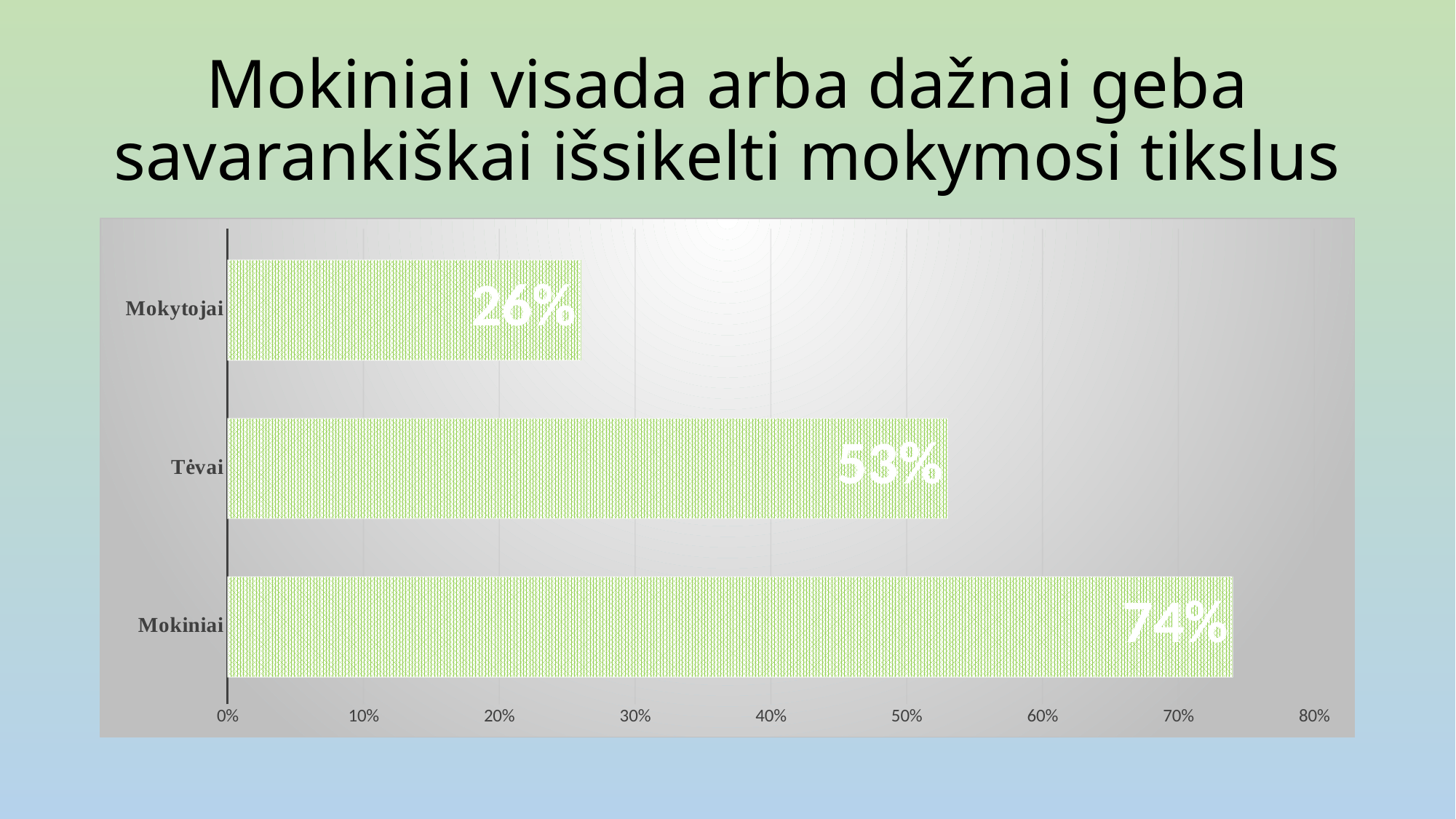
How many categories are shown in the chart? 3 What is the difference between the values for Tėvai and Mokytojai? 27% What is the title of the slide? Mokiniai visada arba dažnai geba savarankiškai išsikelti mokymosi tikslus What is the value for Mokiniai? 74% What is the difference between the values for Mokiniai and Mokytojai? 48% What is the value for Tėvai? 53% Which category has the lowest value? Mokytojai Which category has the highest value? Mokiniai Is the value for Tėvai greater or less than 50%? greater What is the value for Mokytojai? 26% Which is larger, the value for Tėvai or the value for Mokytojai? Tėvai What kind of chart is shown on the slide? bar chart